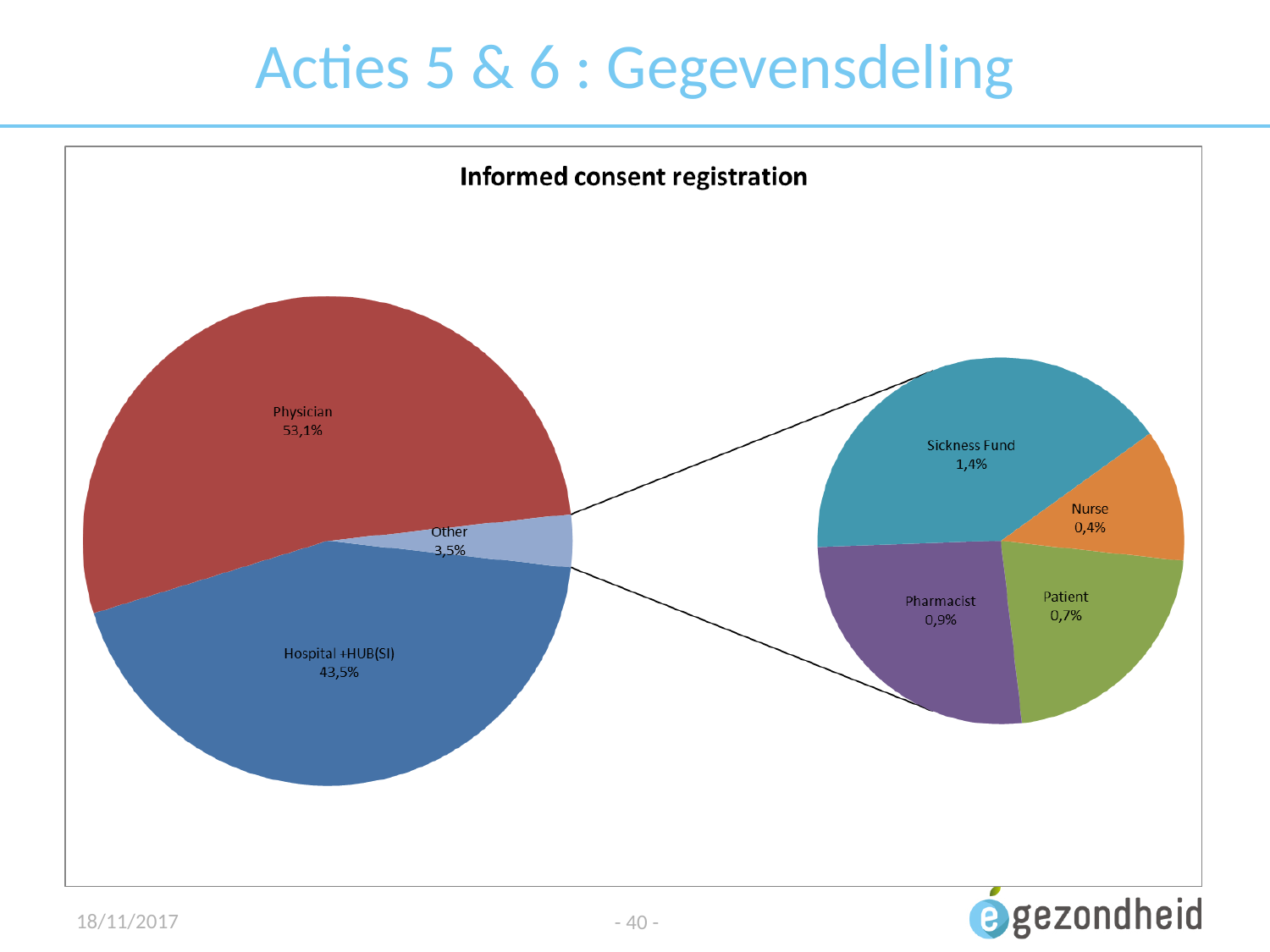
Which is larger, the share for Pharmacist or the share for Patient? Pharmacist Which category has the smallest share in the breakdown pie on the right? Nurse What kind of chart is shown on the slide? pie chart What percentage is shown for Physician? 53,1% What percentage is shown for Sickness Fund? 1,4% What percentage is shown for Nurse? 0,4% What is the difference in percentage points between Physician and Hospital +HUB(SI)? 9,6 How many slices are in the breakdown pie on the right? 4 What percentage is shown for Hospital +HUB(SI)? 43,5% Which category has the largest share of the main pie? Physician What is the chart title? Informed consent registration What percentage is shown for Other in the main pie? 3,5%